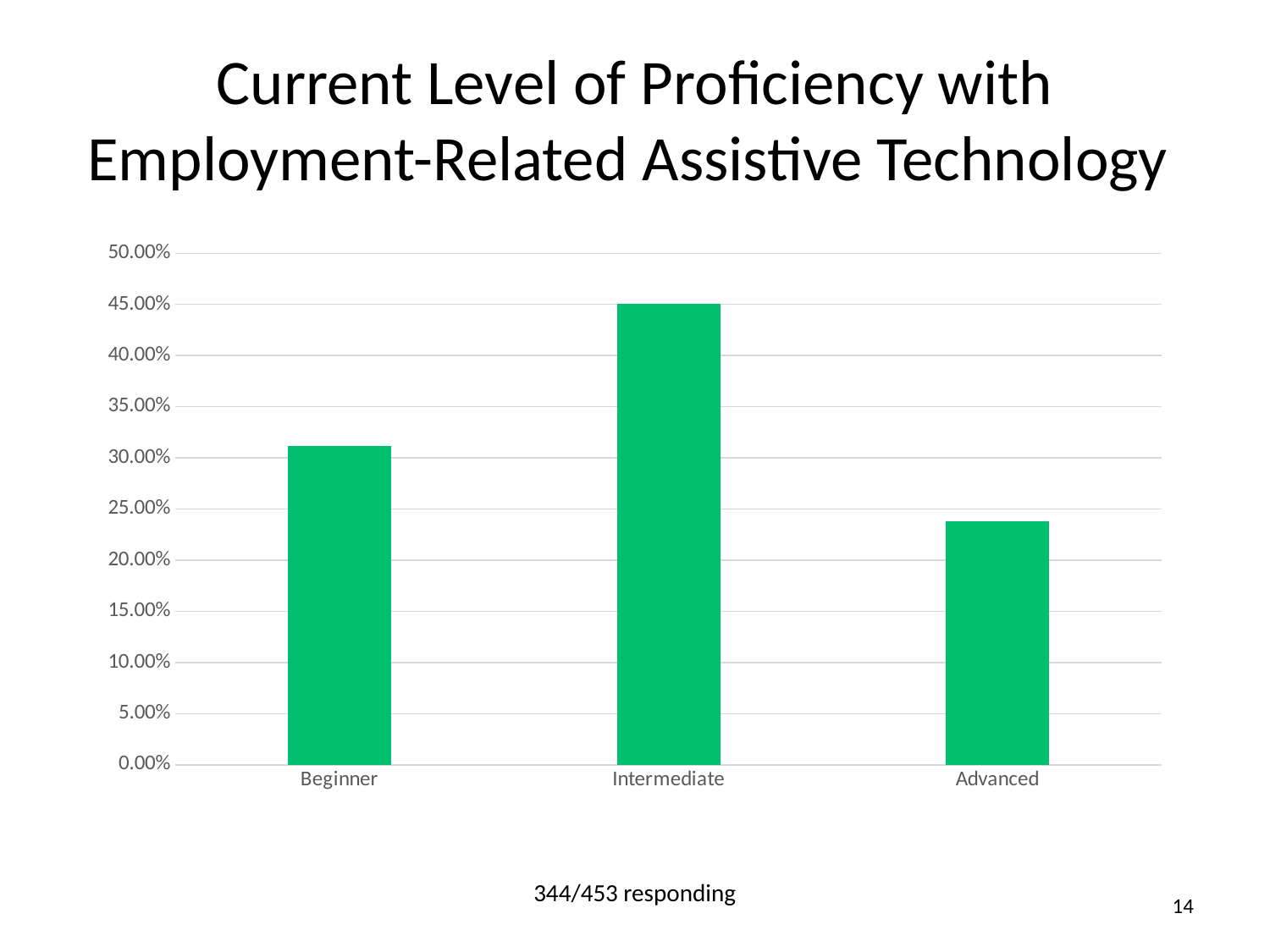
Is the value for Advanced greater or less than 20.00%? greater How many categories are shown on the x axis of the chart? 3 What is the title of the chart on the slide? Current Level of Proficiency with Employment-Related Assistive Technology Which proficiency level has the lowest value? Advanced Is the value for Advanced greater or less than 25.00%? less Which proficiency level has the highest value? Intermediate Which is larger, the value for Beginner or the value for Advanced? Beginner Is the value for Beginner greater or less than 30.00%? greater What kind of chart is shown on the slide? bar chart According to the note below the chart, how many respondents answered this question? 344/453 responding